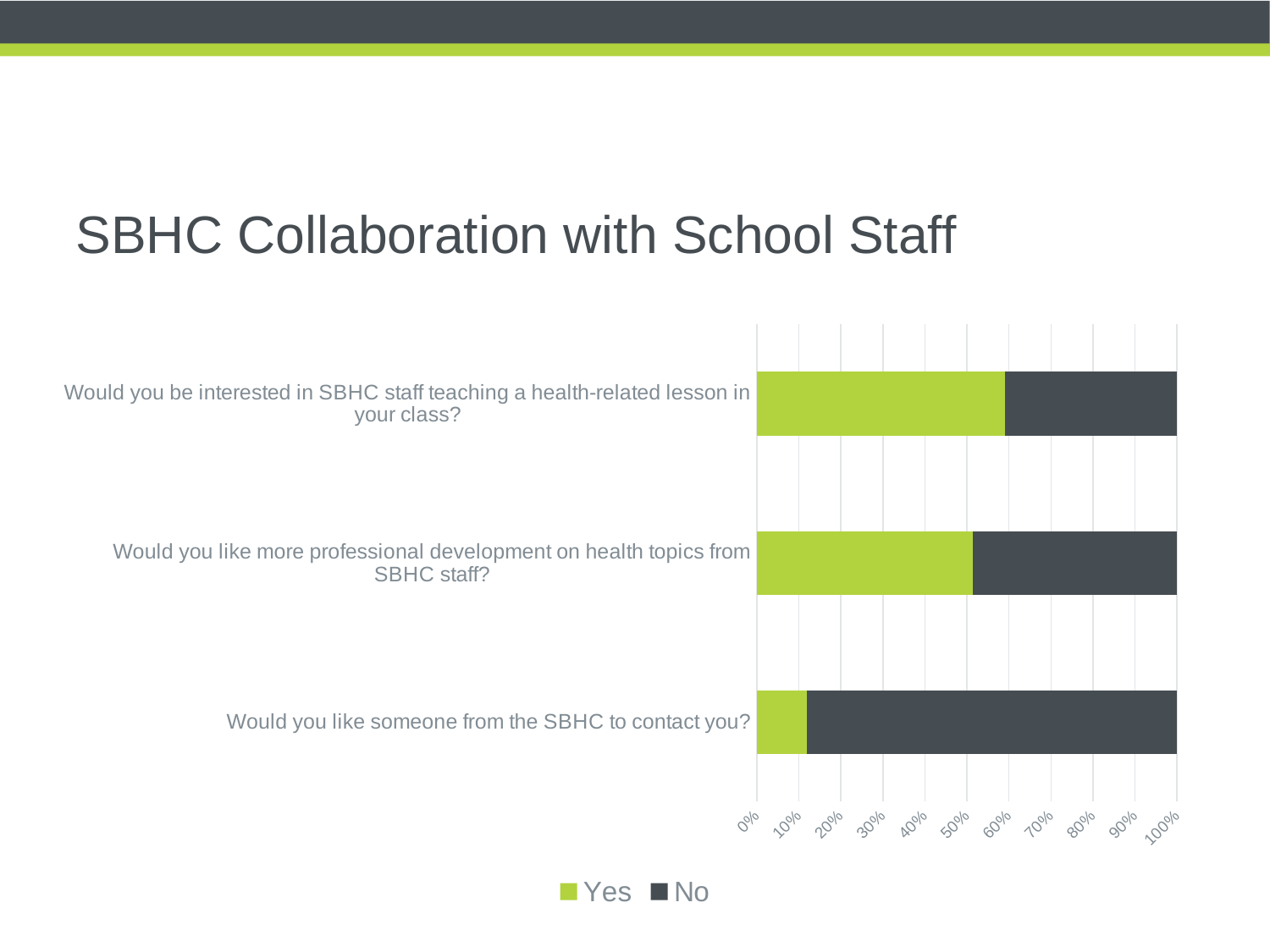
How many series does the legend list? 2 Is the "Yes" share for "Would you like someone from the SBHC to contact you?" greater or less than 20%? less Which question has the smallest "Yes" share? Would you like someone from the SBHC to contact you? Is the "No" share for "Would you like someone from the SBHC to contact you?" greater or less than 80%? greater For "Would you like someone from the SBHC to contact you?", which is larger, the "Yes" share or the "No" share? No What is the title of the slide containing the chart? SBHC Collaboration with School Staff Which question has the largest "Yes" share? Would you be interested in SBHC staff teaching a health-related lesson in your class? What kind of chart is shown on the slide? bar chart How many questions (categories) are plotted in the chart? 3 For "Would you be interested in SBHC staff teaching a health-related lesson in your class?", which is larger, the "Yes" share or the "No" share? Yes Is the "Yes" share for "Would you be interested in SBHC staff teaching a health-related lesson in your class?" greater or less than 50%? greater Which colour represents the "Yes" series in the chart? green